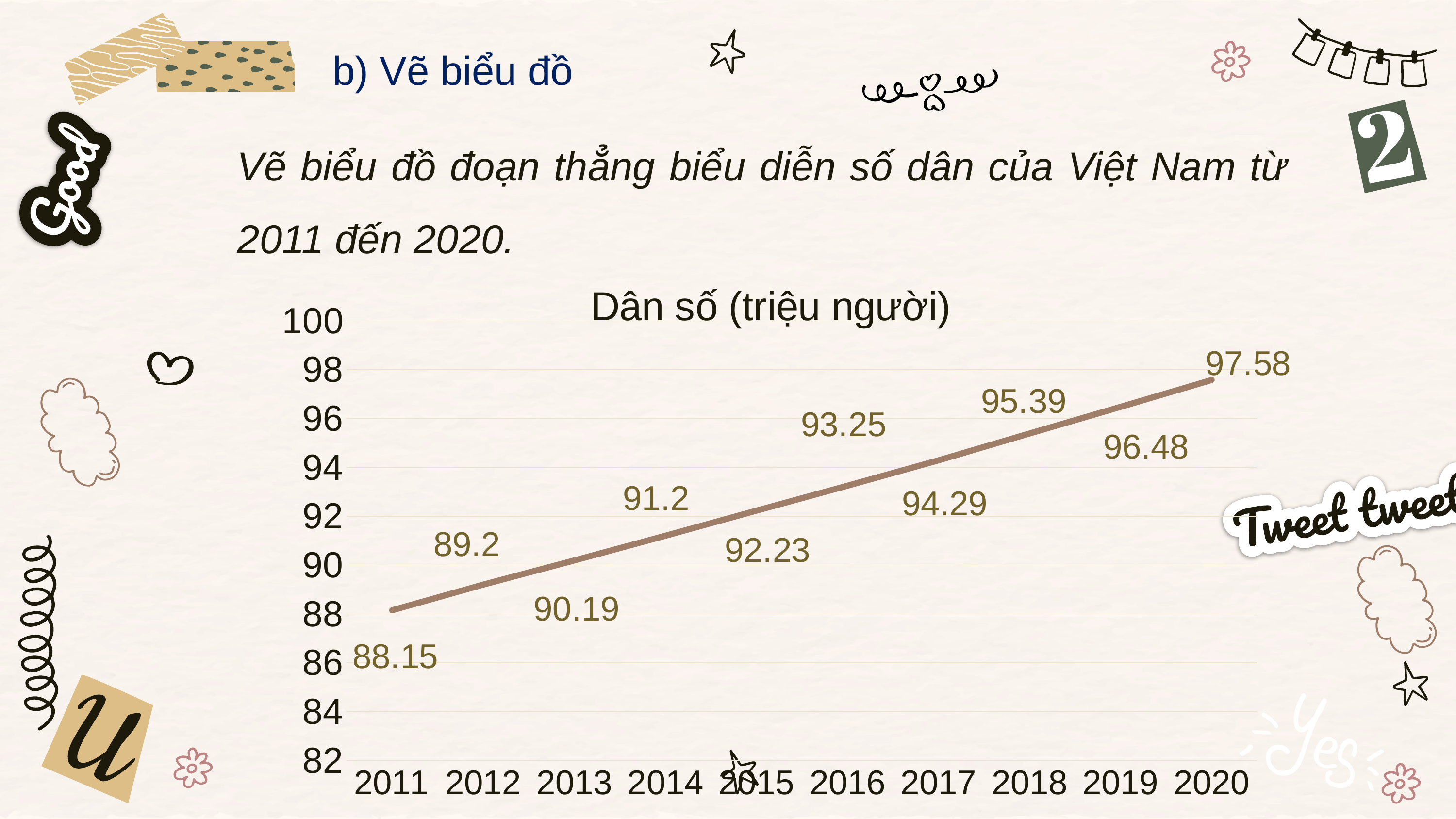
Which is larger, the value for 2017 or the value for 2014? 2017 What is the value for 2015? 92.23 What is the value for 2020? 97.58 How many years are plotted on the x axis? 10 Which year has the lowest value? 2011 Is the value for 2018 greater or less than 94? greater What is the title of the chart? Dân số (triệu người) Which year has the highest value? 2020 Do the values rise or fall from 2011 to 2020? Rise What is the difference between the values for 2020 and 2011? 9.43 What is the value for 2011? 88.15 What type of chart is shown on the slide? Line chart